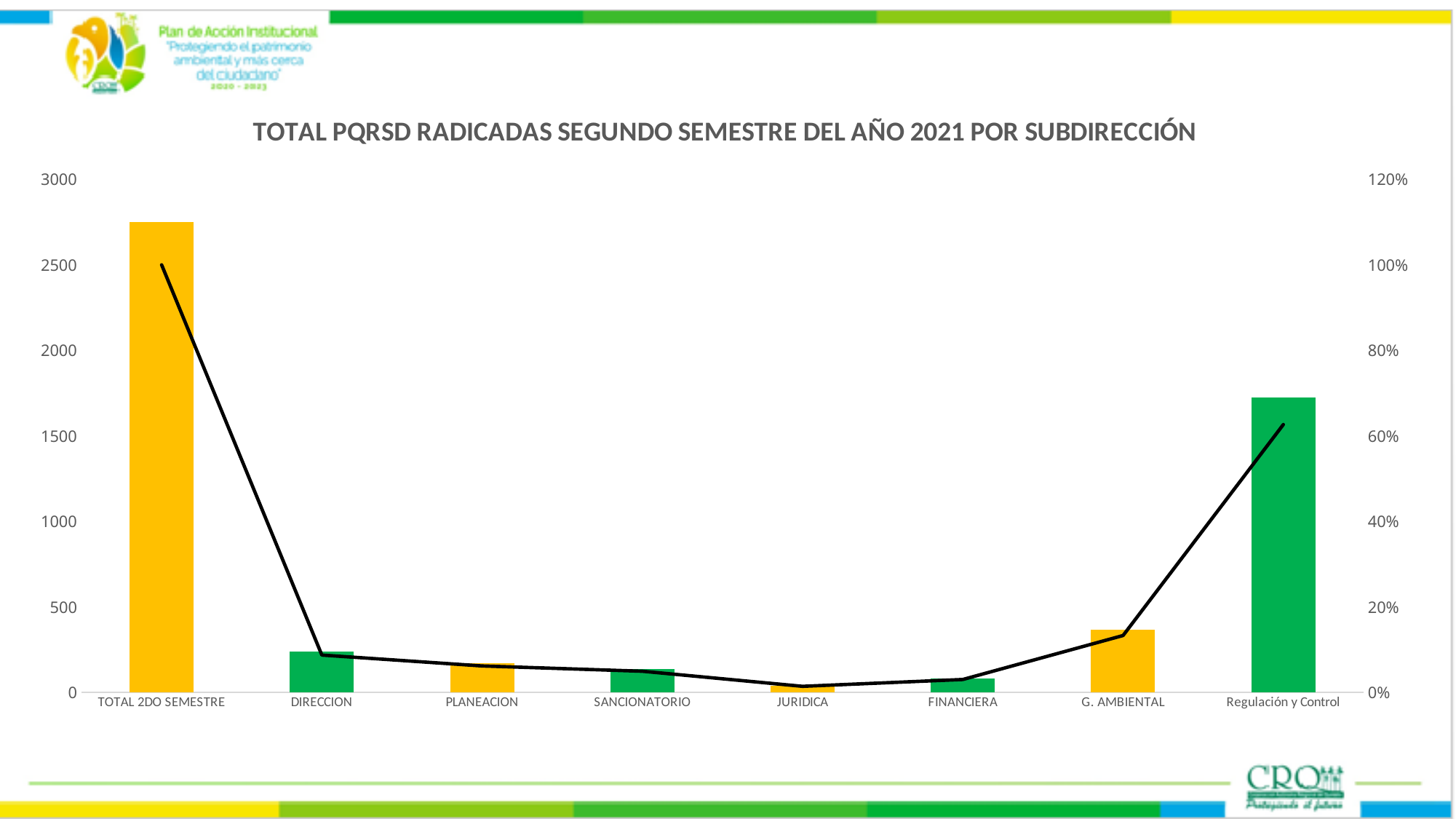
Which bar is taller, DIRECCION or FINANCIERA? DIRECCION Which bar is taller, G. AMBIENTAL or PLANEACION? G. AMBIENTAL Is the bar for G. AMBIENTAL greater or less than 500? less Is the bar for TOTAL 2DO SEMESTRE greater or less than 2500? greater How many categories are shown on the x axis? 8 Excluding TOTAL 2DO SEMESTRE, which subdirección has the tallest bar? Regulación y Control Is the bar for Regulación y Control greater or less than 1500? greater Which category has the shortest bar? JURIDICA What is the title of the chart? TOTAL PQRSD RADICADAS SEGUNDO SEMESTRE DEL AÑO 2021 POR SUBDIRECCIÓN What percentage does the line show for TOTAL 2DO SEMESTRE on the right axis? 100% Which category has the tallest bar? TOTAL 2DO SEMESTRE What kind of chart is shown on the slide? Bar chart with a line